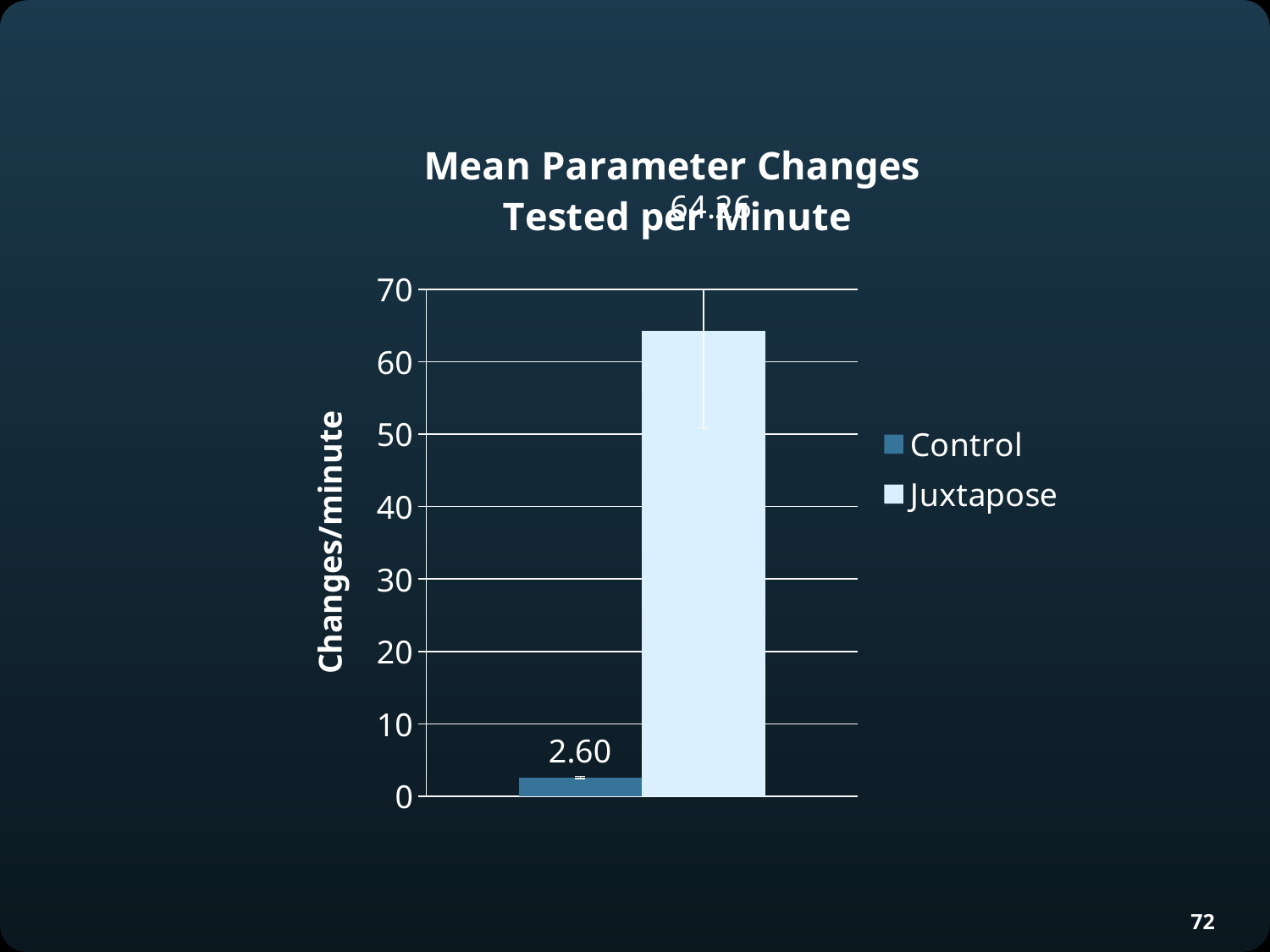
How many bars are plotted in the chart? 2 What is the value for Control? 2.60 What kind of chart is shown on the slide? bar chart Which series has the highest value? Juxtapose Which series has the lowest value? Control What is the label on the vertical axis? Changes/minute Which is larger, the value for Control or the value for Juxtapose? Juxtapose What is the title of the chart? Mean Parameter Changes Tested per Minute Is the value for Juxtapose greater or less than 60? greater Is the value for Control greater or less than 10? less How many series does the legend list? 2